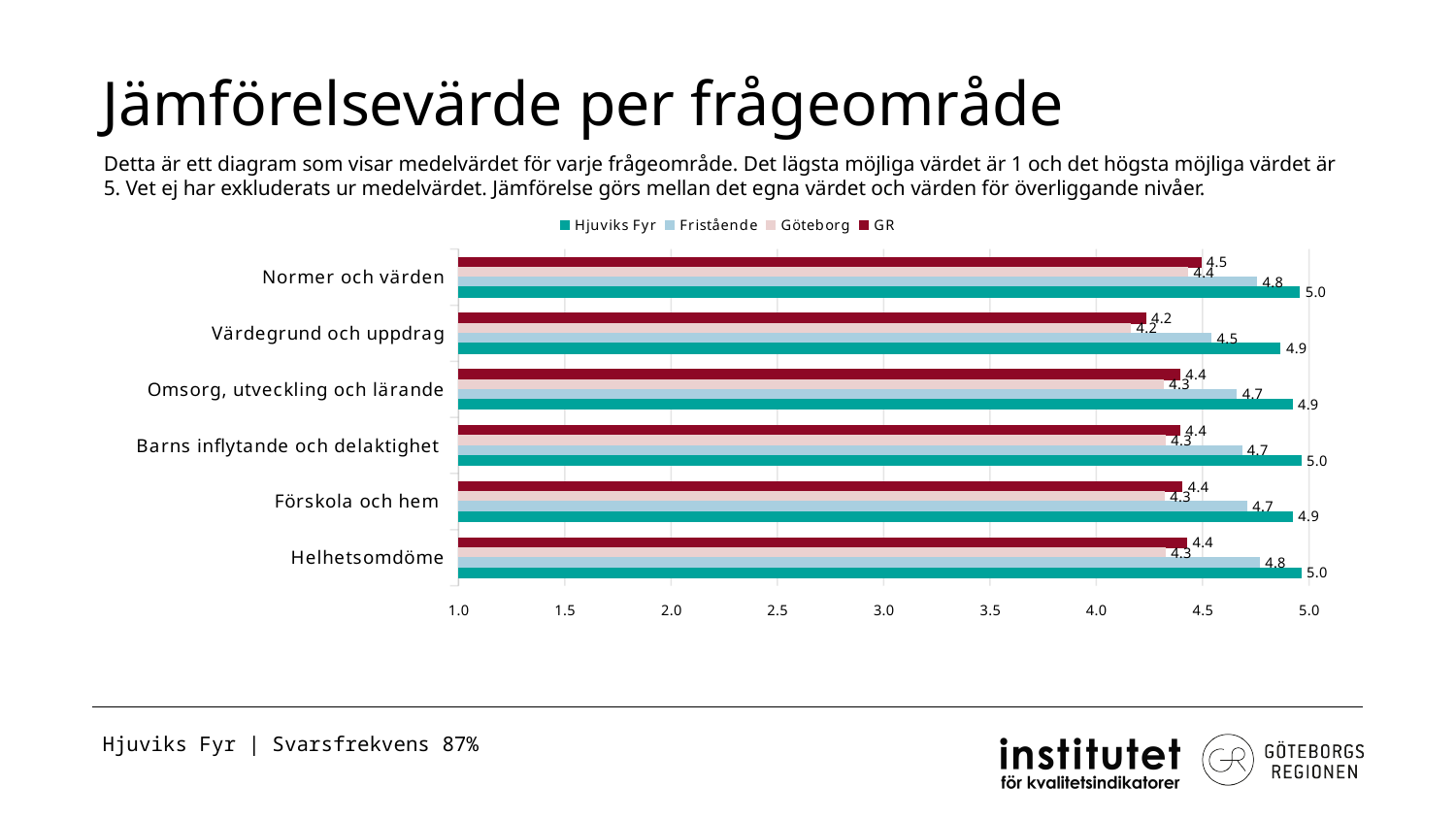
How many series does the legend list? 4 What is the difference between the Hjuviks Fyr value and the GR value in the category Helhetsomdöme? 0.6 Which series is shown in dark red in the legend? GR What is the value for GR in the category Värdegrund och uppdrag? 4.2 What kind of chart is shown on the slide? Bar chart Which category has the lowest value for the Fristående series? Värdegrund och uppdrag What is the value for Fristående in the category Helhetsomdöme? 4.8 In the category Normer och värden, which is larger: the value for Fristående or the value for GR? Fristående How many categories are shown on the chart? 6 What is the value for Hjuviks Fyr in the category Normer och värden? 5.0 What is the difference between the Hjuviks Fyr value and the Göteborg value in the category Värdegrund och uppdrag? 0.7 What is the value for Göteborg in the category Omsorg, utveckling och lärande? 4.3